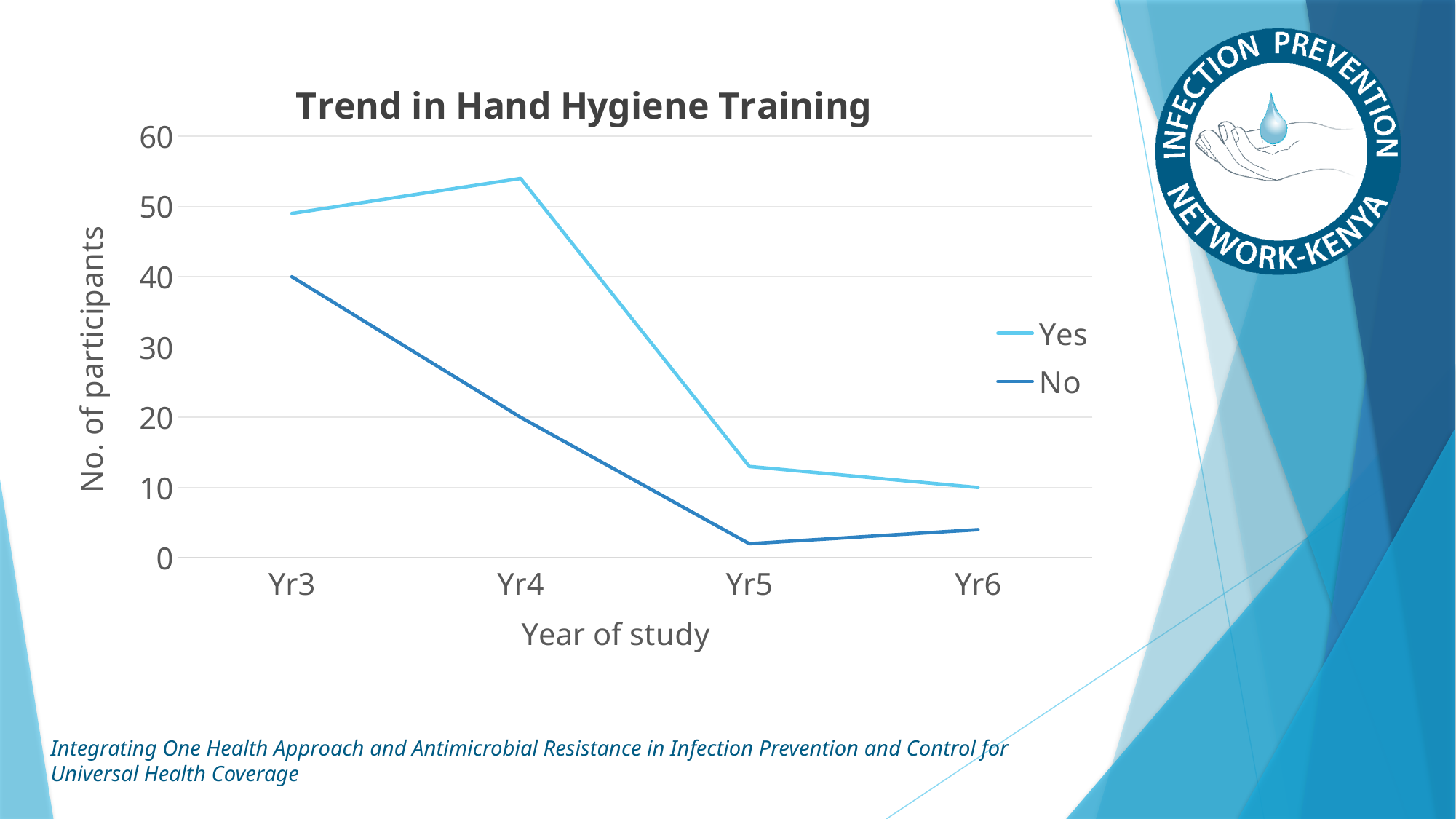
In which year does the Yes series reach its highest value? Yr4 At Yr4, which series has the larger value, Yes or No? Yes What is the label of the vertical axis? No. of participants How many years of study are shown on the x axis? 4 In which year does the No series reach its lowest value? Yr5 What is the title of the chart? Trend in Hand Hygiene Training What kind of chart is shown on the slide? line chart Is the value for No at Yr4 greater or less than 30? less Is the value for Yes at Yr3 greater or less than 40? greater Is the value for Yes at Yr5 greater or less than 20? less How many series does the legend list? 2 Does the Yes series rise or fall from Yr4 to Yr6? fall